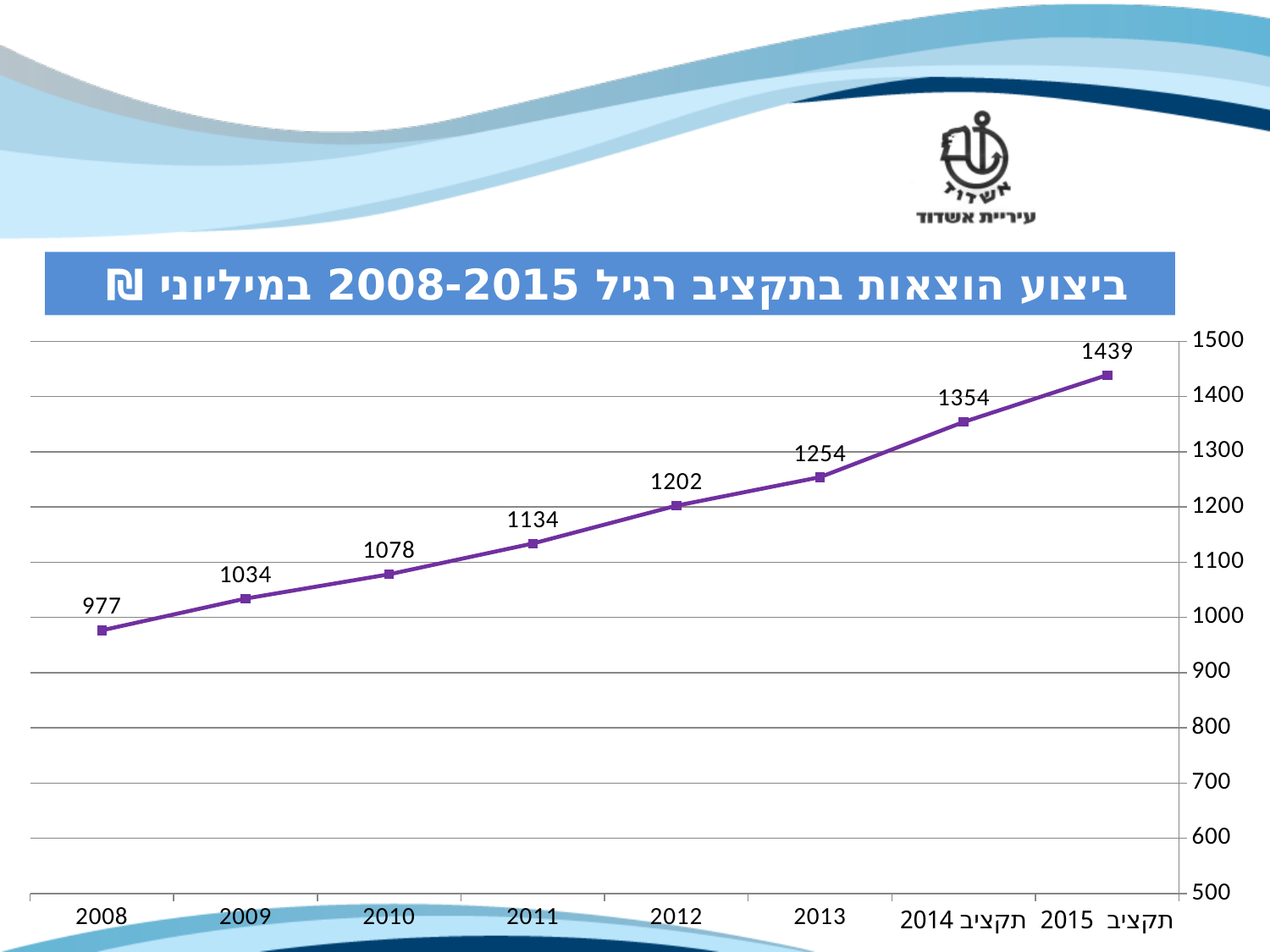
What is the value for 2013? 1254 What is the value for תקציב 2015? 1439 How many data points are plotted on the line? 8 Which is larger, the value for 2010 or the value for 2009? 2010 Do the values rise or fall from 2008 to תקציב 2015? Rise What is the value for 2008? 977 Which year has the lowest value? 2008 What type of chart is shown on the slide? Line chart Which year has the highest value? תקציב 2015 What is the difference between the values for 2012 and 2011? 68 What is the difference between the values for תקציב 2015 and 2008? 462 What is the value for 2011? 1134